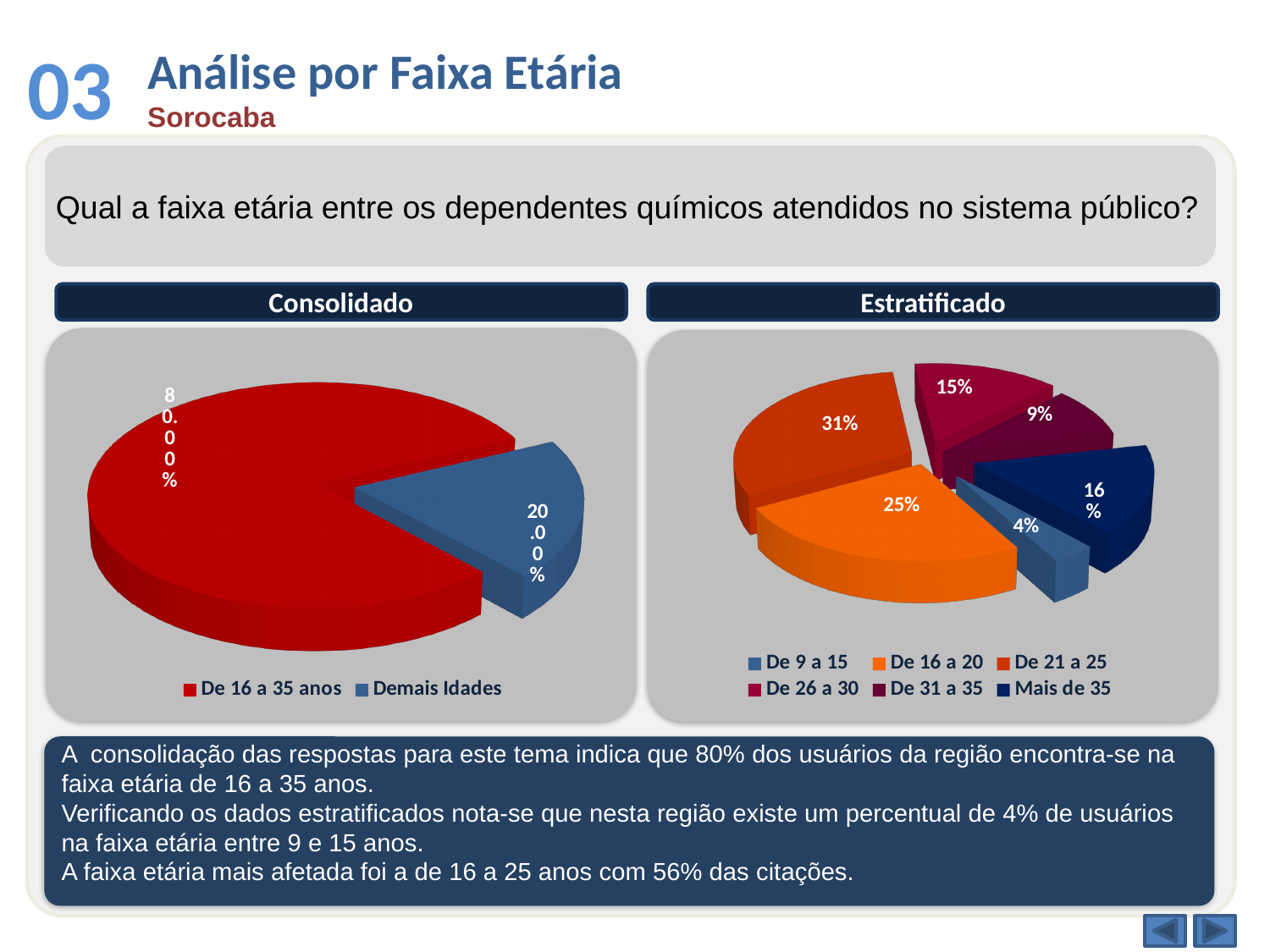
In the Estratificado chart, which age group has the largest share? De 21 a 25 In the Estratificado chart, what is the difference between the shares of De 16 a 20 and De 26 a 30? 10% In the Estratificado chart, what percentage is shown for Mais de 35? 16% In the Consolidado chart, what percentage is shown for De 16 a 35 anos? 80.00% In the Estratificado chart, which is larger: the share for De 31 a 35 or the share for Mais de 35? Mais de 35 How many categories does the legend of the Estratificado chart list? 6 In the Consolidado chart, which category has the larger share? De 16 a 35 anos In the Estratificado chart, what percentage is shown for De 9 a 15? 4% In the Estratificado chart, what percentage is shown for De 21 a 25? 31% In the Estratificado chart, which age group has the smallest share? De 9 a 15 In the Consolidado chart, what percentage is shown for Demais Idades? 20.00% What kind of chart is the Consolidado chart? Pie chart